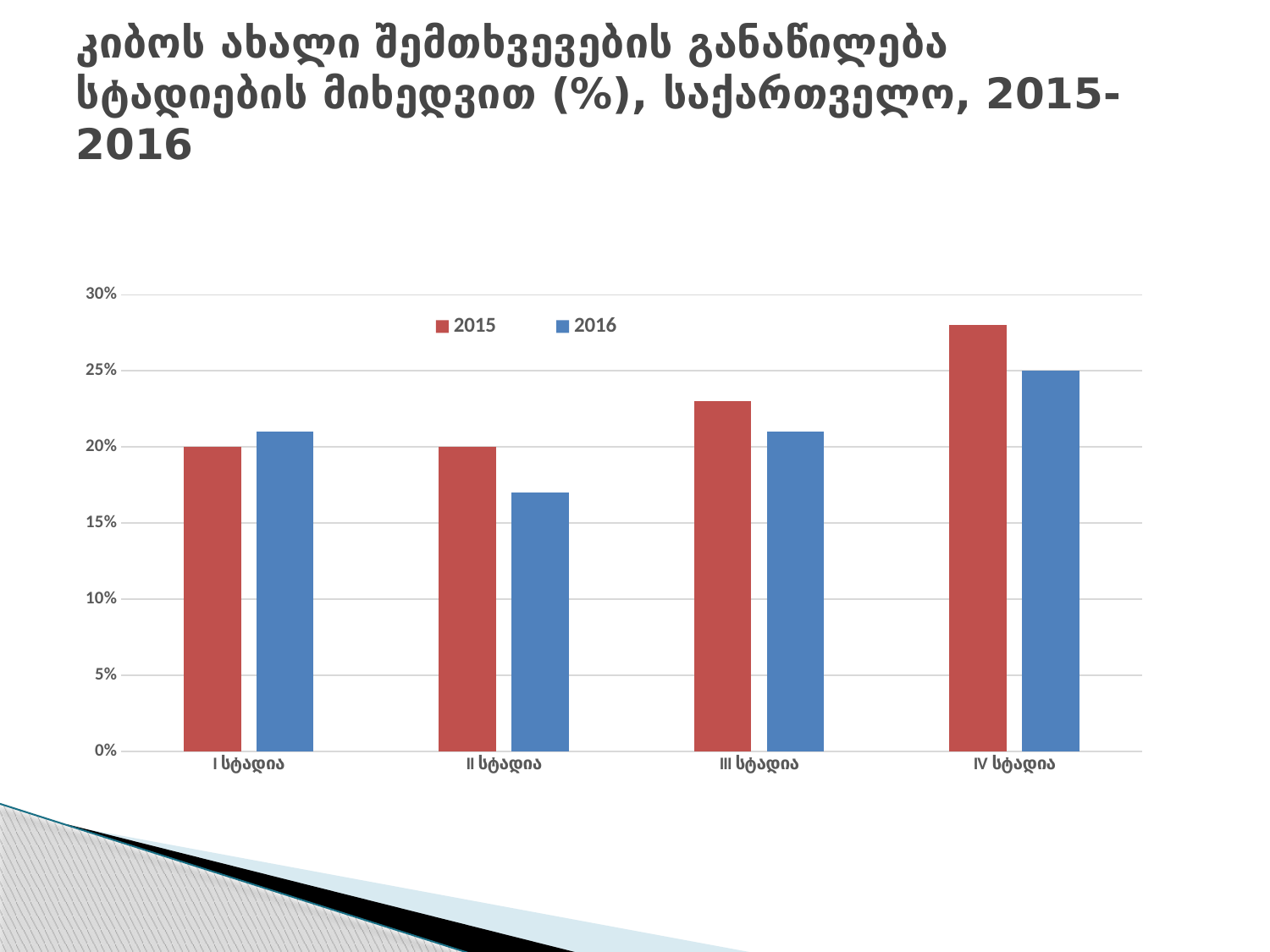
Is the 2015 value for IV სტადია greater or less than 25%? greater How many stage categories are shown on the x axis? 4 How many series does the legend list? 2 What is the difference between the 2016 value for IV სტადია and the 2015 value for II სტადია? 5% Which stage has the highest 2015 value? IV სტადია Is the 2016 value for II სტადია greater or less than 20%? less What kind of chart is shown on the slide? bar chart Which stage has the lowest 2016 value? II სტადია What is the 2015 value for I სტადია? 20% For IV სტადია, which year has the larger value, 2015 or 2016? 2015 What is the 2016 value for IV სტადია? 25% What is the 2015 value for II სტადია? 20%